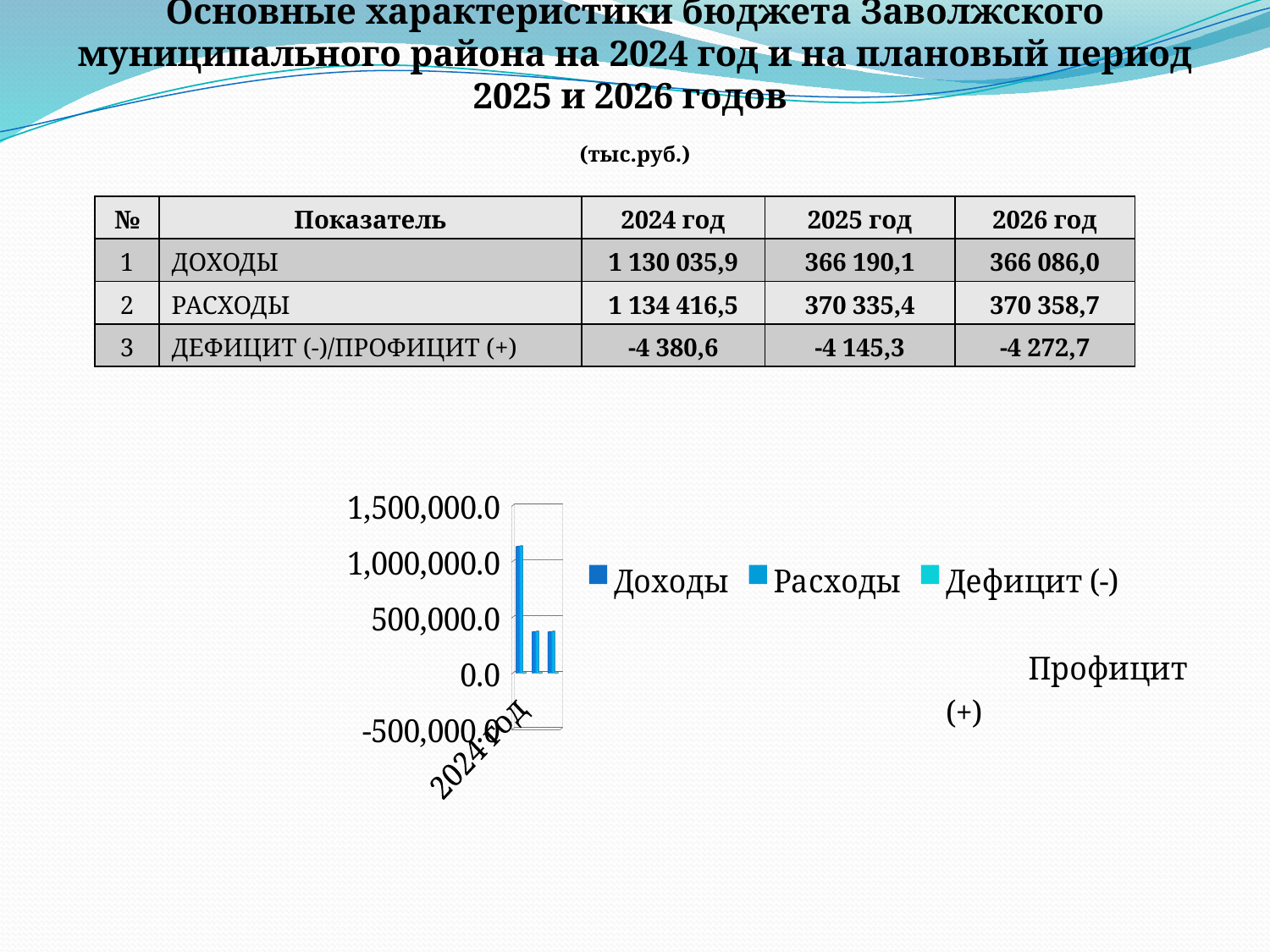
What are the series names listed in the chart's legend? Доходы, Расходы, Дефицит (-) Профицит (+) Is the value of the tallest bar in the chart greater or less than 1,000,000? greater Which is taller in the chart, the leftmost bar or the second bar from the left? the leftmost bar What kind of chart is shown at the bottom of the slide? bar chart Is the value of the tallest bar in the chart greater or less than 1,500,000? less How many series does the chart's legend list? 3 Is the value of the rightmost bar in the chart greater or less than 500,000? less What is the highest tick value shown on the chart's vertical axis? 1,500,000.0